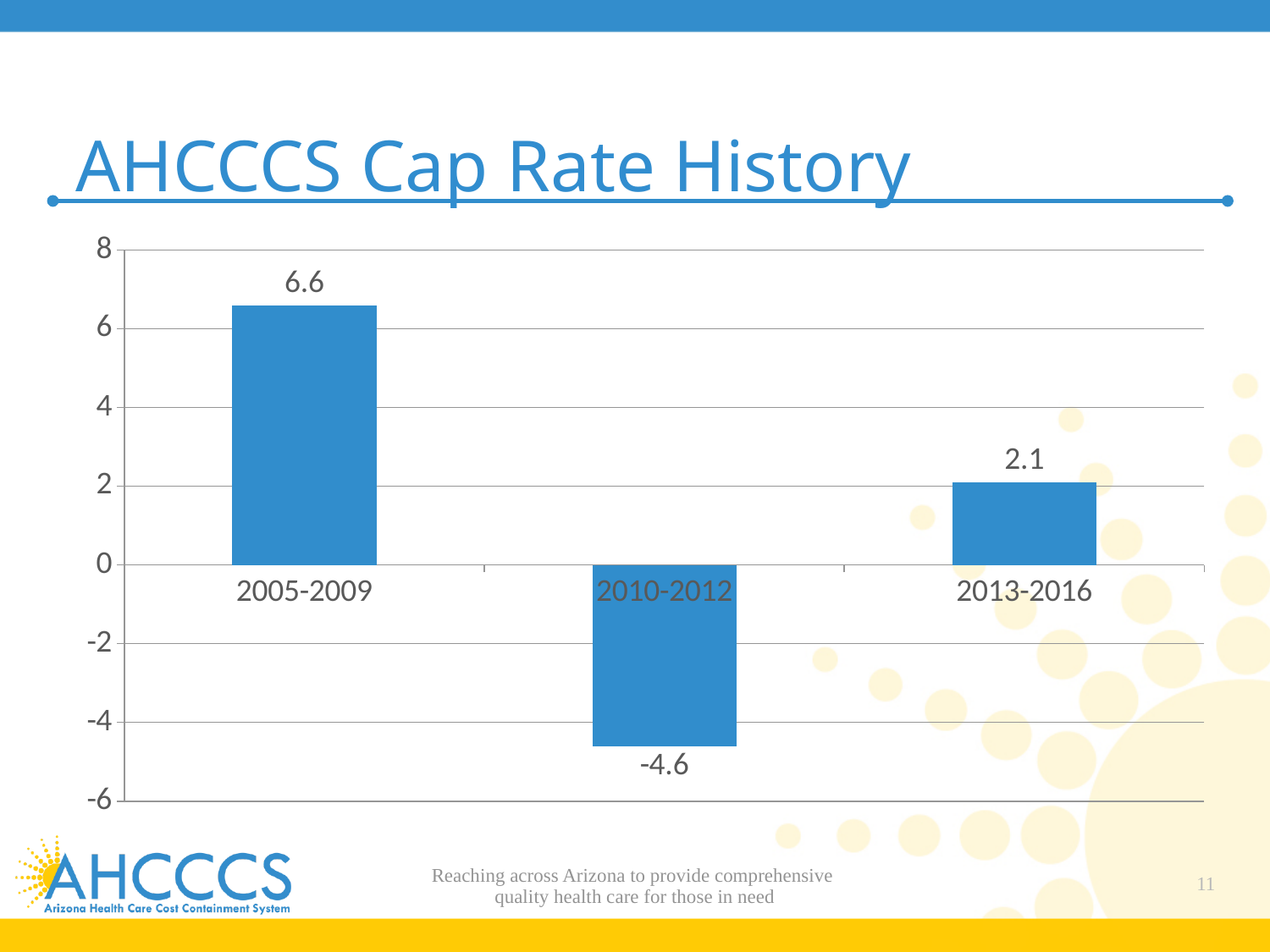
How many periods are shown on the chart? 3 Is the value for 2005-2009 greater or less than 6? greater What is the title of the chart? AHCCCS Cap Rate History What kind of chart is shown on the slide? bar chart How many bars have a negative value? 1 What is the value for 2005-2009? 6.6 Which period has the highest value? 2005-2009 What is the difference between the values for 2005-2009 and 2013-2016? 4.5 What is the value for 2013-2016? 2.1 What is the value for 2010-2012? -4.6 Which period has the lowest value? 2010-2012 Which is larger, the value for 2013-2016 or the value for 2010-2012? 2013-2016